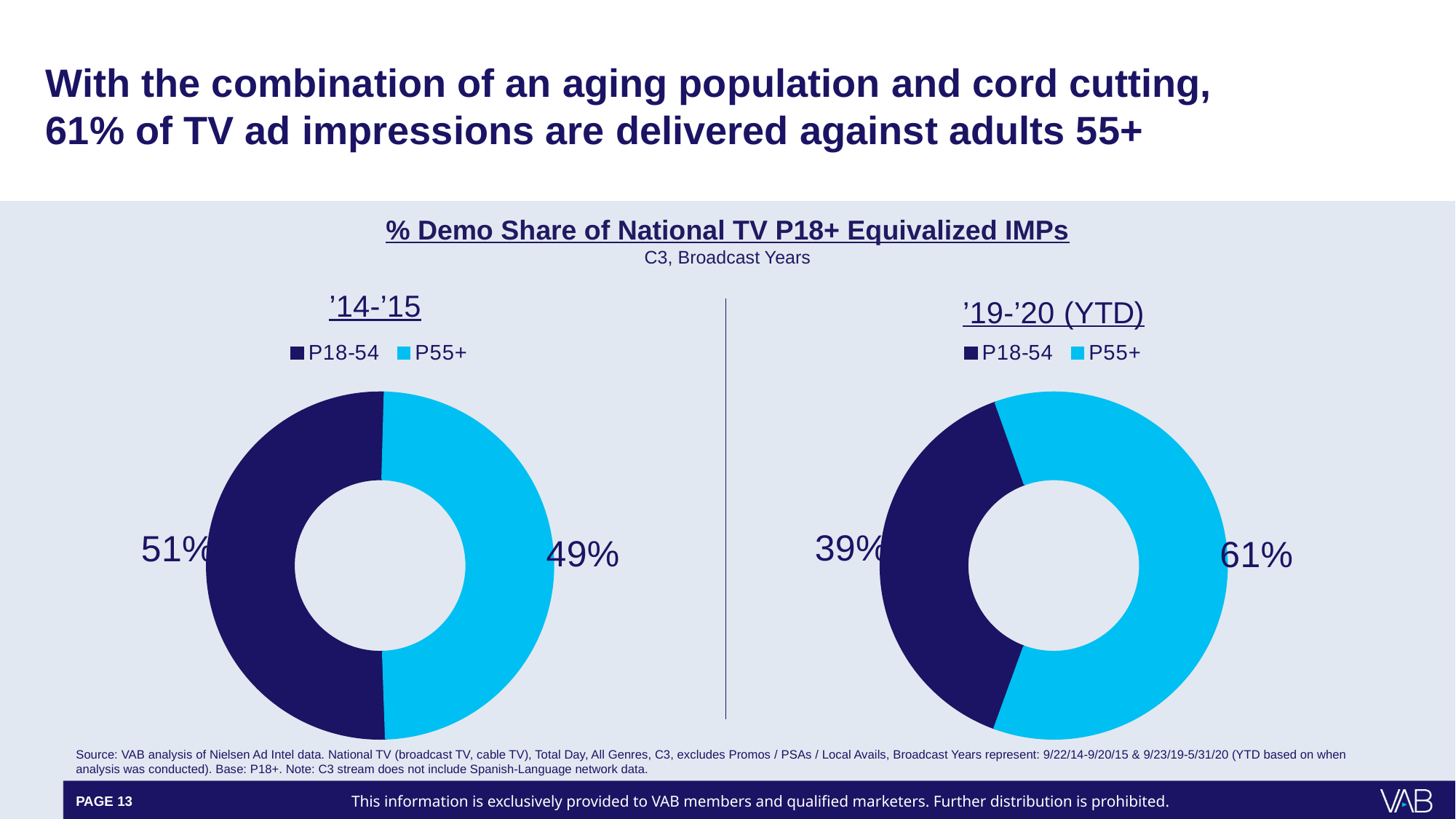
How many series does the legend of the '19-'20 (YTD) chart list? 2 In the '14-'15 chart, what is the difference between the P18-54 share and the P55+ share? 2 percentage points In the '19-'20 (YTD) chart, which demo has the smallest share? P18-54 In the '14-'15 chart, what is the share for P55+? 49% What type of chart is used for the '14-'15 data? Doughnut chart In the '19-'20 (YTD) chart, what is the difference between the P55+ share and the P18-54 share? 22 percentage points In the '19-'20 (YTD) chart, what is the share for P18-54? 39% In the '14-'15 chart, what is the share for P18-54? 51% What colour represents P55+ in the '14-'15 chart? Light blue In the '19-'20 (YTD) chart, which demo has the largest share? P55+ Is the P55+ share larger in the '14-'15 chart or the '19-'20 (YTD) chart? '19-'20 (YTD) In the '19-'20 (YTD) chart, what is the share for P55+? 61%